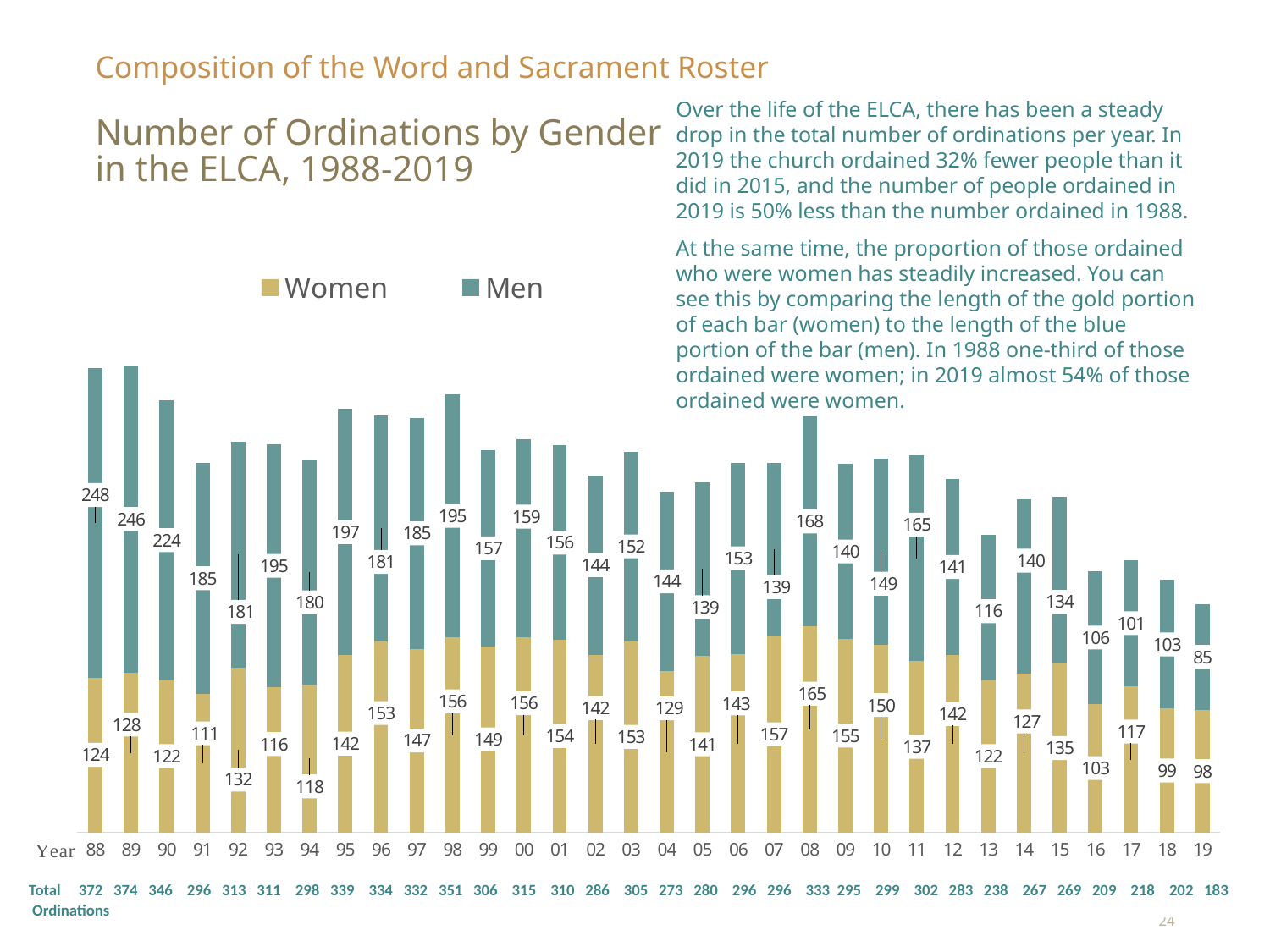
What is the total number of ordinations in 2019 (year 19)? 183 Does the number of men ordained generally rise or fall from 1988 to 2019? Fall What kind of chart is shown on the slide? Stacked bar chart In which year was the number of men ordained the lowest? 19 In 2019 (year 19), were more women or more men ordained? Women In which year was the number of men ordained the highest? 88 How many series does the legend list? 2 How many women were ordained in 2008 (year 08)? 165 In which year was the number of women ordained the highest? 08 How many men were ordained in 1988 (year 88)? 248 How many years are shown on the x axis of the chart? 32 What is the difference between the number of men and the number of women ordained in 1988 (year 88)? 124